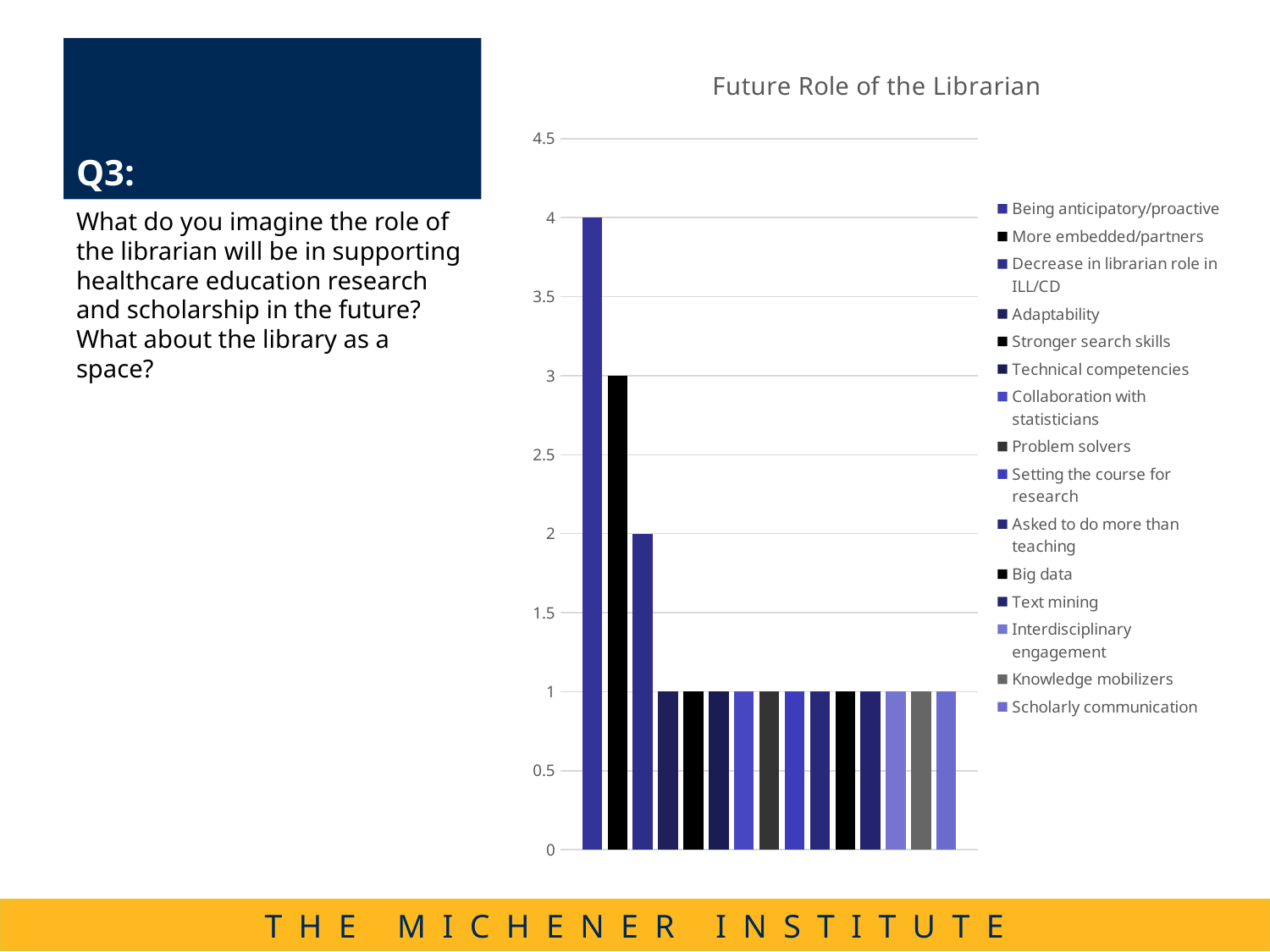
How many bars are plotted in the chart? 15 Is the value for 'Being anticipatory/proactive' greater or less than 3.5? greater How many entries does the chart's legend list? 15 What is the value for 'More embedded/partners'? 3 What is the value for 'Decrease in librarian role in ILL/CD'? 2 What is the value for 'Being anticipatory/proactive'? 4 Which legend entry has the highest value in the chart? Being anticipatory/proactive Do the bar values rise or fall from left to right across the chart? fall What is the title of the chart? Future Role of the Librarian Which is larger, the value for 'More embedded/partners' or the value for 'Decrease in librarian role in ILL/CD'? More embedded/partners What type of chart is shown on the slide? bar chart What is the difference between the values for 'Being anticipatory/proactive' and 'More embedded/partners'? 1